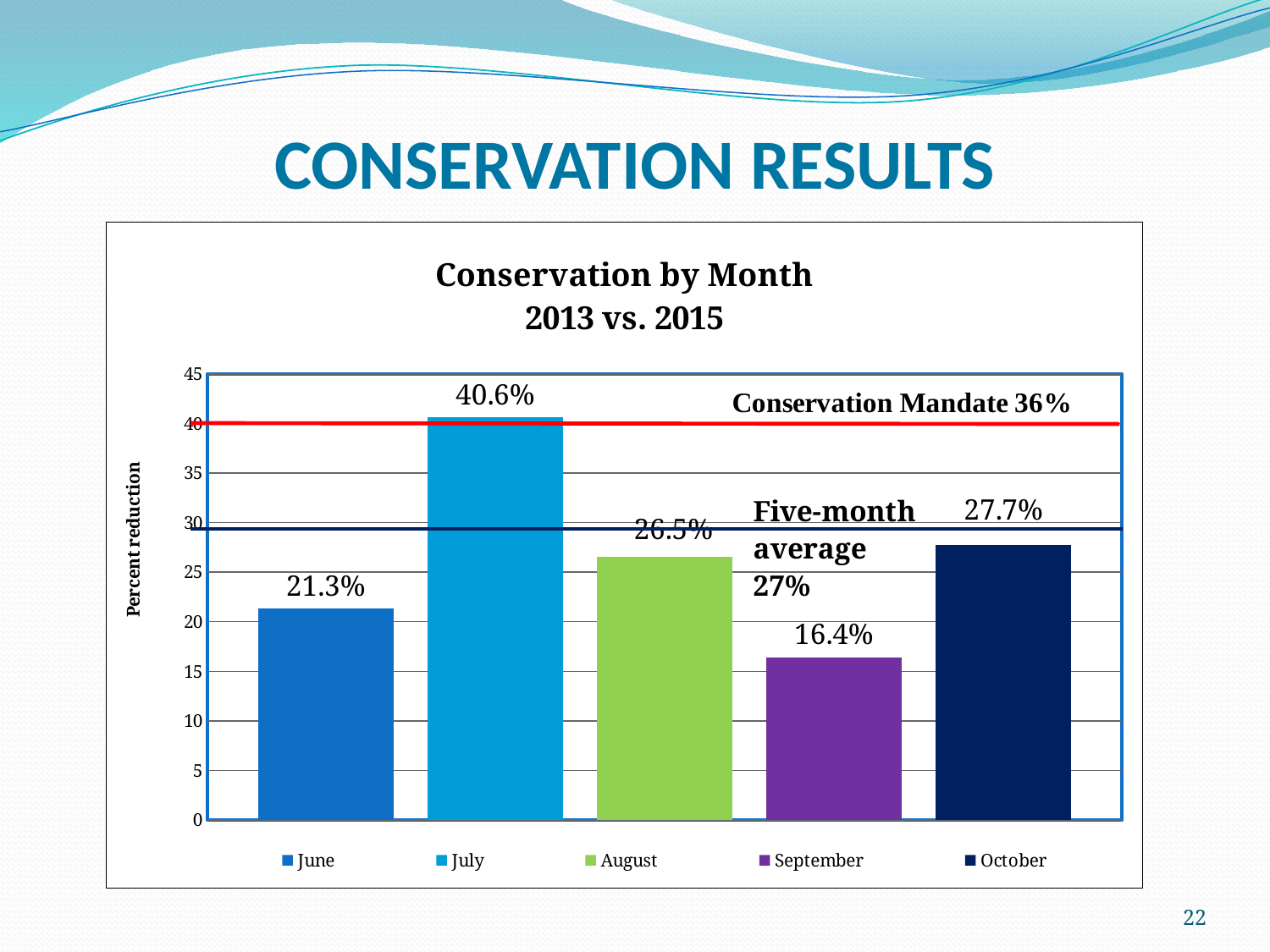
What is the percent reduction for October? 27.7% What kind of chart is shown on the slide? bar chart What is the difference between the percent reduction for July and for June? 19.3% What is the percent reduction for September? 16.4% What is the five-month average shown on the chart? 27% Is the value for June greater or less than 25? less How many months are shown in the chart? 5 Which month has the highest percent reduction? July What is the Conservation Mandate value shown on the chart? 36% Which has a larger percent reduction, August or October? October Which month has the lowest percent reduction? September What is the percent reduction for July? 40.6%